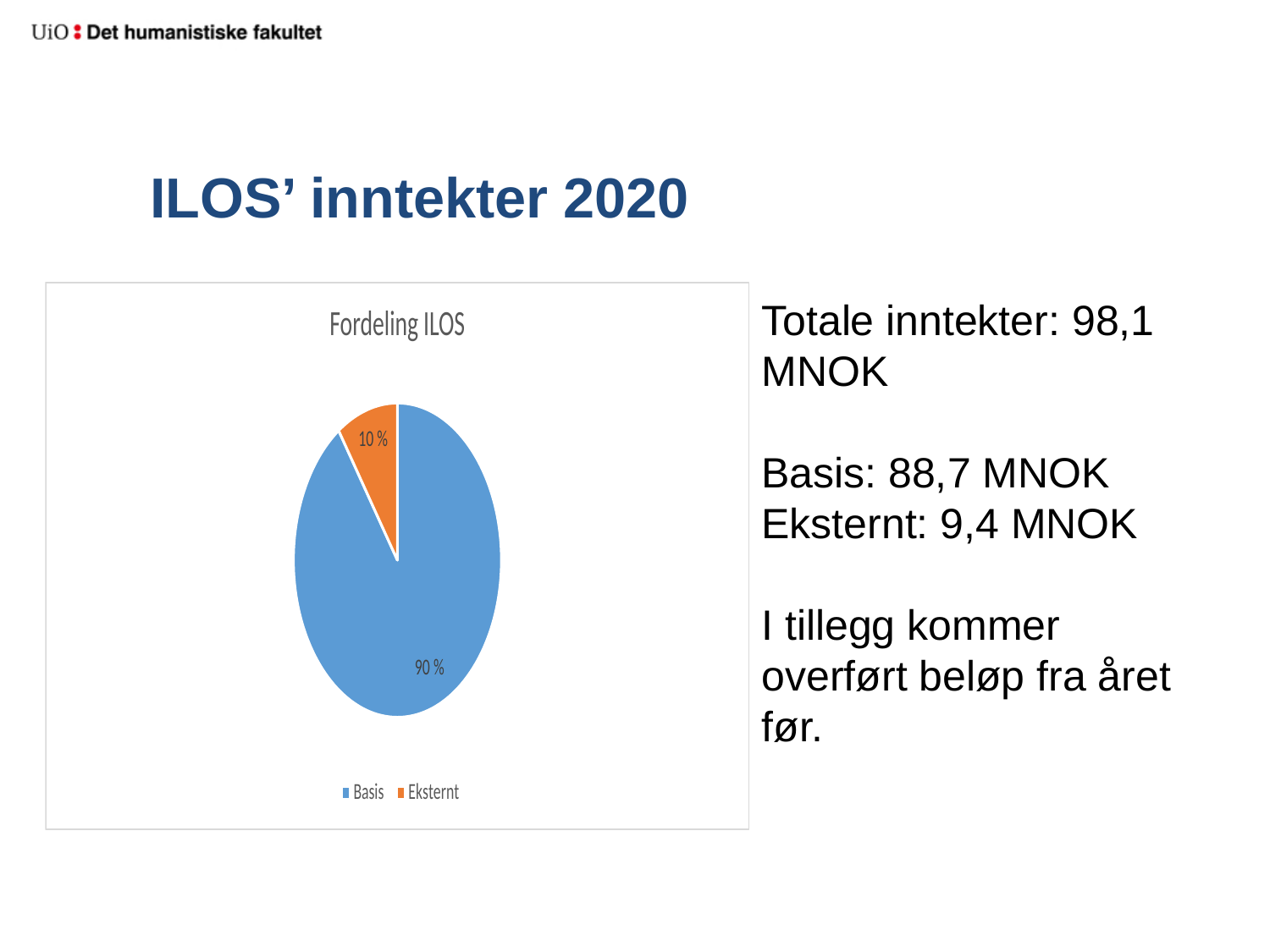
Which is larger, the Basis slice or the Eksternt slice? Basis What colour is the Eksternt slice? orange What is the difference in percentage points between the Basis and Eksternt slices? 80 percentage points What is the title of the chart? Fordeling ILOS What share of the pie does Basis represent? 90 % Which slice of the pie is the largest? Basis What share of the pie does Eksternt represent? 10 % How many entries does the legend list? 2 How many slices does the pie chart have? 2 What kind of chart is shown on the slide? pie chart Which slice of the pie is the smallest? Eksternt